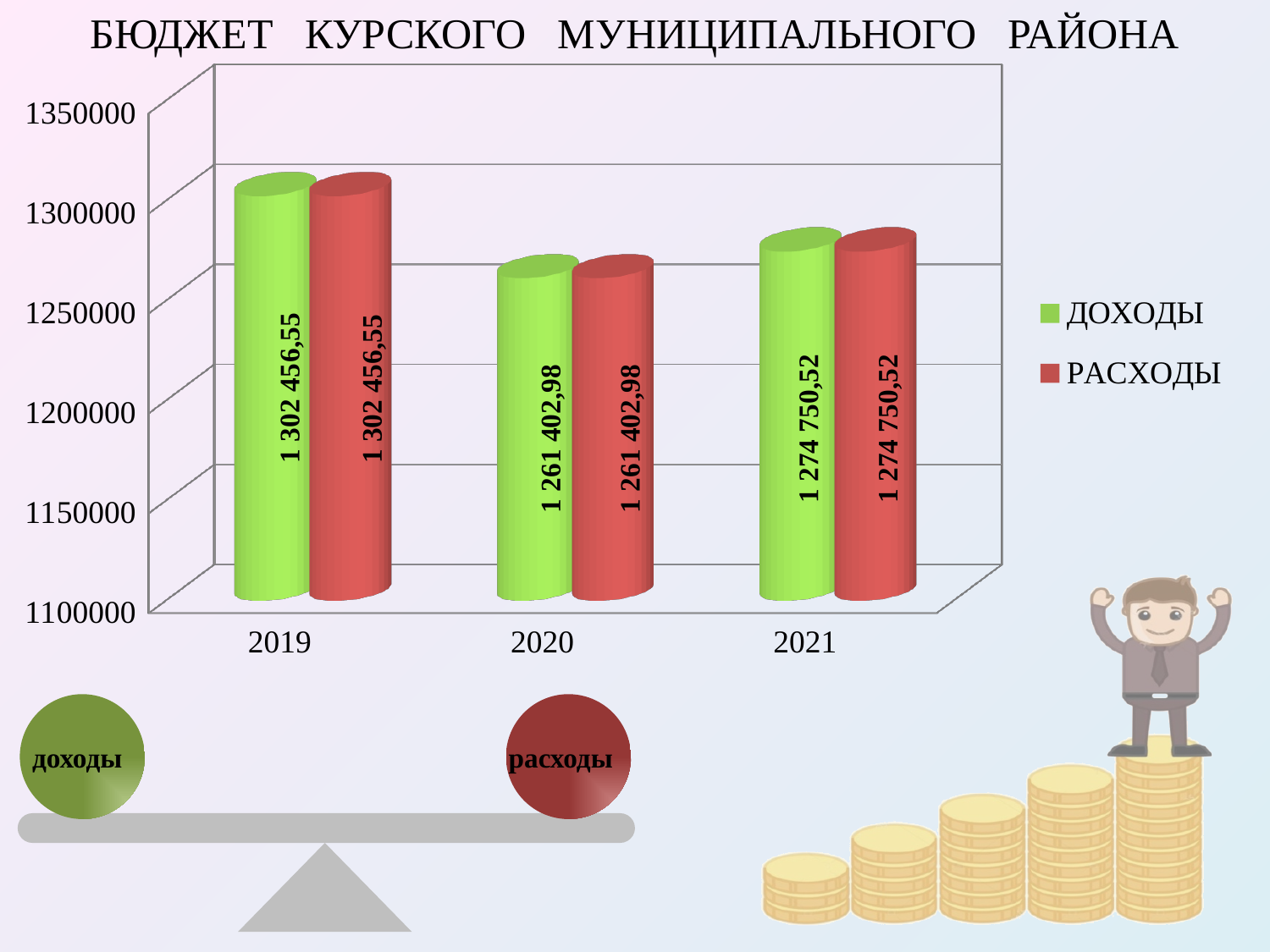
How many series does the legend list? 2 What is the difference between the ДОХОДЫ value for 2019 and the ДОХОДЫ value for 2020? 41 053,57 What is the ДОХОДЫ value for 2021? 1 274 750,52 What is the РАСХОДЫ value for 2020? 1 261 402,98 Which is larger: the РАСХОДЫ value for 2021 or the РАСХОДЫ value for 2020? 2021 Do the ДОХОДЫ values rise or fall from 2019 to 2020? fall In which year is the РАСХОДЫ value lowest? 2020 In which year is the ДОХОДЫ value highest? 2019 How many years are shown on the x axis? 3 Is the РАСХОДЫ value for 2020 greater or less than 1300000? less What kind of chart is shown on the slide? bar chart What is the ДОХОДЫ value for 2019? 1 302 456,55